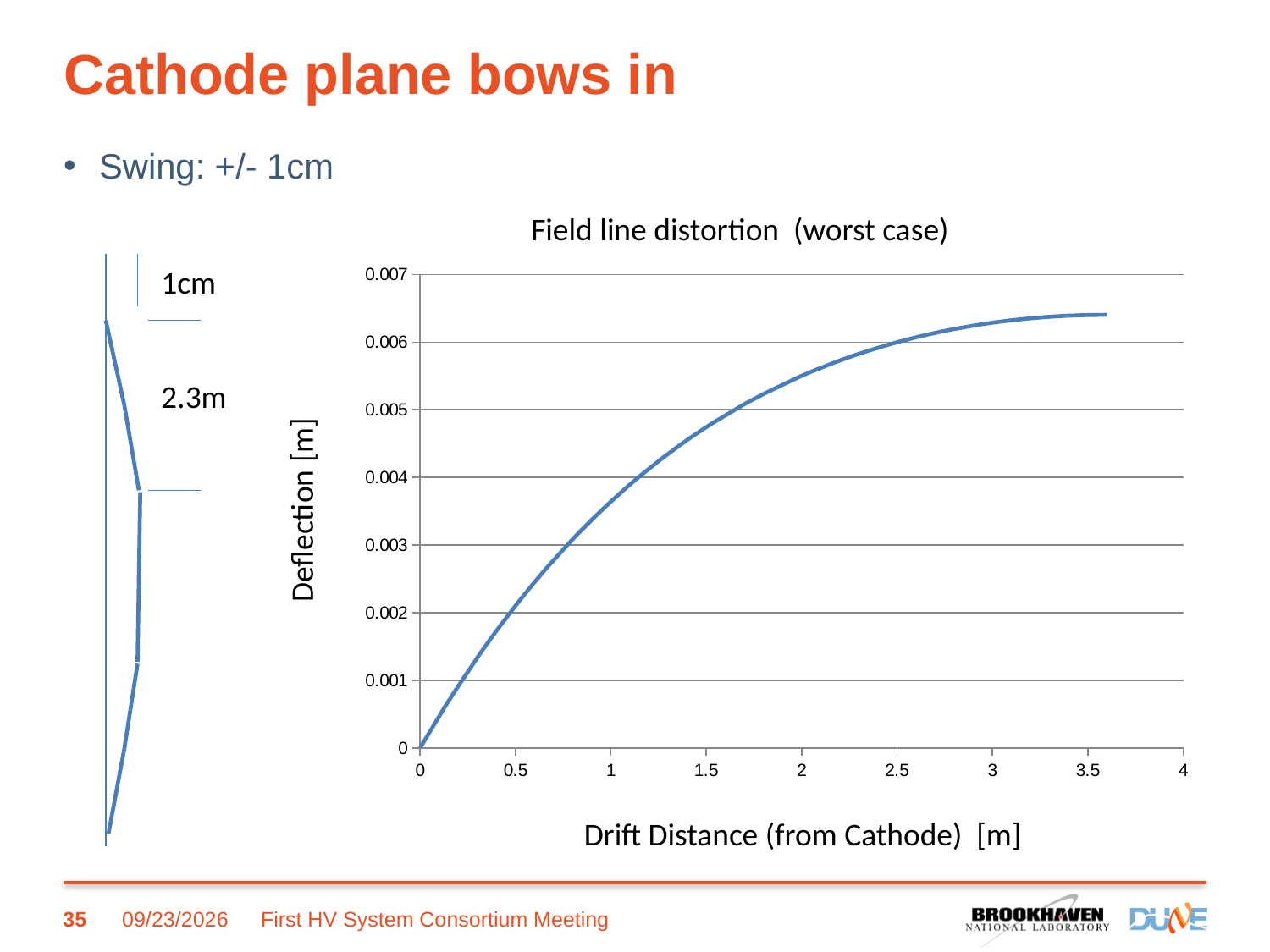
Does the deflection rise or fall as drift distance increases? rise What is the label of the x axis of the chart? Drift Distance (from Cathode) [m] Is the deflection at a drift distance of 3.5 m greater or less than 0.007? less What kind of chart is shown on the slide? line chart Is the deflection larger at a drift distance of 1 m or at 3 m? 3 m Is the deflection at a drift distance of 1 m greater or less than 0.003? greater Is the deflection at a drift distance of 0.5 m greater or less than 0.004? less At which end of the drift distance range is the deflection lowest, 0 m or 3.5 m? 0 m What is the deflection at a drift distance of 0 m? 0 What is the title of the chart? Field line distortion (worst case)